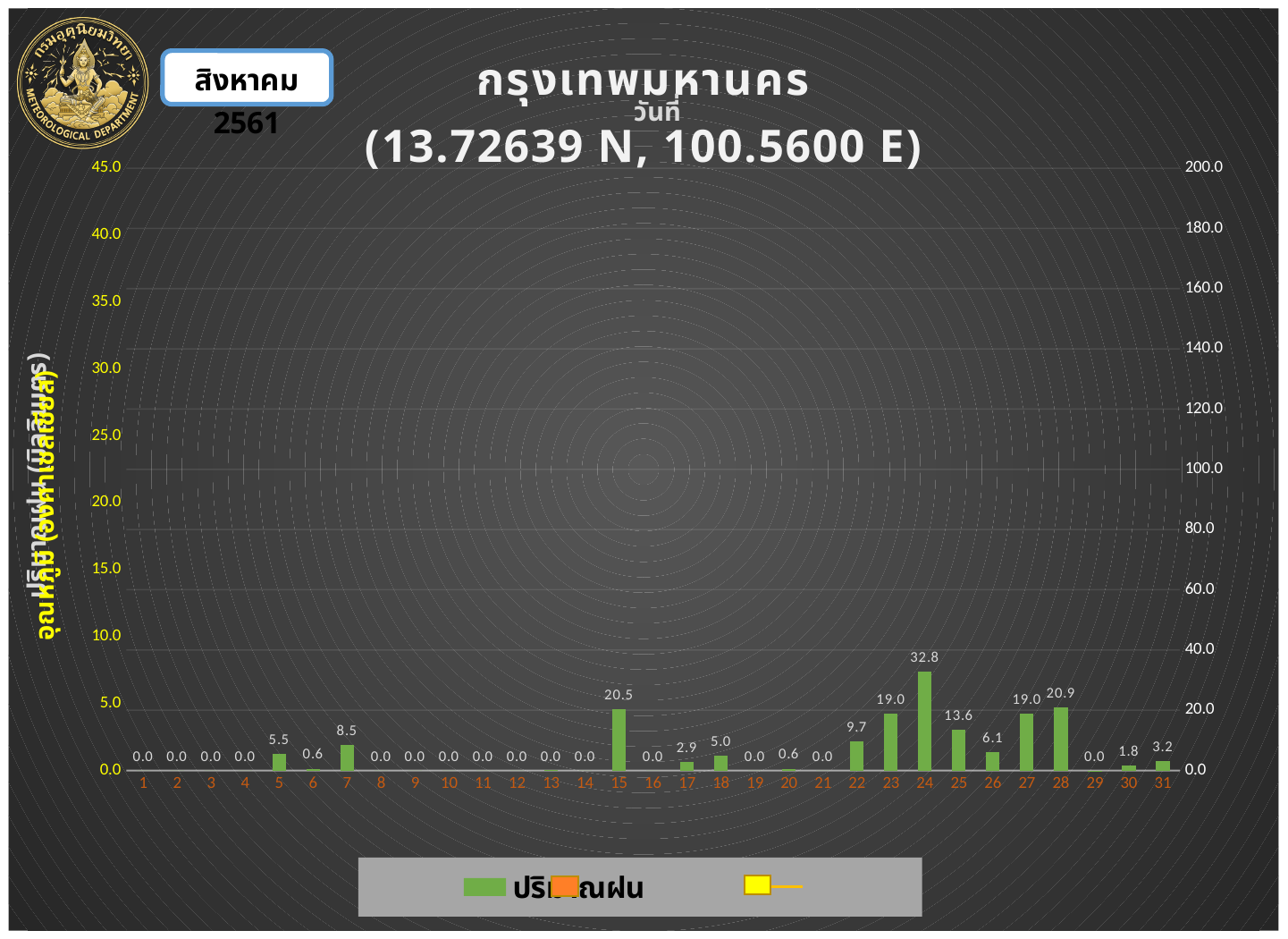
What is the total rainfall for days 27 and 28 combined? 39.9 What is the rainfall value shown for day 7? 8.5 Is the rainfall value for day 24 greater or less than 20.0 on the right axis? greater What is the rainfall value shown for day 25? 13.6 Which day has the highest rainfall value? 24 What kind of chart is used to show the rainfall values? Bar chart Which has a larger rainfall value, day 22 or day 26? Day 22 How many days are shown on the x axis? 31 What is the rainfall value shown for day 24? 32.8 What colour are the rainfall bars? Green What is the rainfall value shown for day 15? 20.5 What is the difference between the rainfall values for day 24 and day 28? 11.9